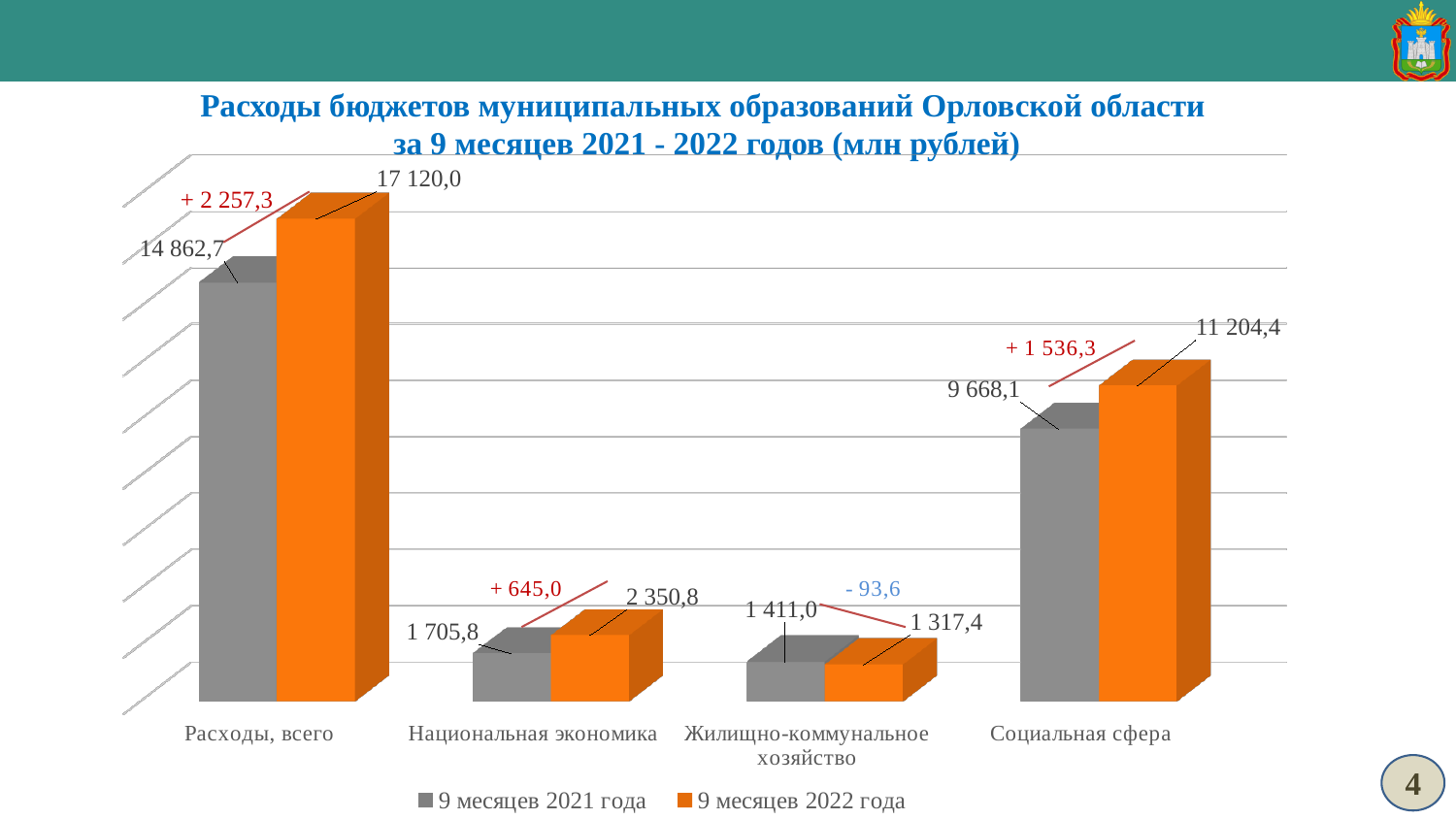
What is the difference between the 2022 and 2021 values for «Социальная сфера»? 1 536,3 What kind of chart is shown on the slide? Bar chart Which category has the lowest value in the «9 месяцев 2022 года» series? Жилищно-коммунальное хозяйство Which category has the highest value in the «9 месяцев 2021 года» series? Расходы, всего What is the value for «Социальная сфера» in the «9 месяцев 2021 года» series? 9 668,1 What is the value for «Жилищно-коммунальное хозяйство» in the «9 месяцев 2022 года» series? 1 317,4 What is the value for «Национальная экономика» in the «9 месяцев 2021 года» series? 1 705,8 What is the difference between the 2021 and 2022 values for «Жилищно-коммунальное хозяйство»? 93,6 How many categories are shown on the x axis? 4 What is the value for «Расходы, всего» in the «9 месяцев 2022 года» series? 17 120,0 For «Жилищно-коммунальное хозяйство», which is larger: the «9 месяцев 2021 года» value or the «9 месяцев 2022 года» value? 9 месяцев 2021 года How many series does the legend list? 2